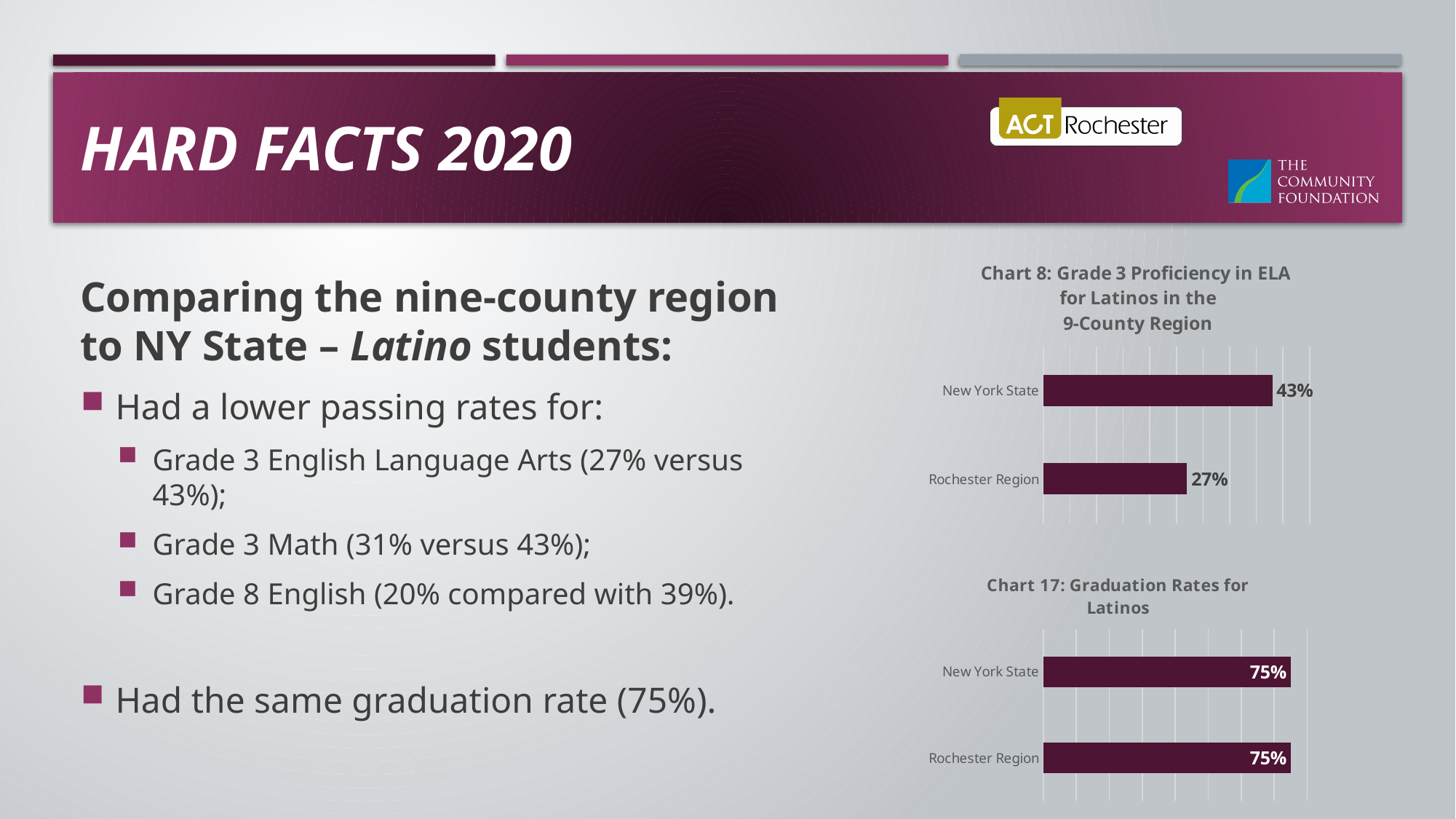
In Chart 8: Grade 3 Proficiency in ELA for Latinos in the 9-County Region, which is larger, the value for New York State or for Rochester Region? New York State What kind of chart is Chart 8: Grade 3 Proficiency in ELA for Latinos in the 9-County Region? Bar chart In Chart 8: Grade 3 Proficiency in ELA for Latinos in the 9-County Region, what is the value for New York State? 43% In Chart 8: Grade 3 Proficiency in ELA for Latinos in the 9-County Region, what is the difference between the New York State and Rochester Region values? 16% How many categories are shown in Chart 8: Grade 3 Proficiency in ELA for Latinos in the 9-County Region? 2 In Chart 17: Graduation Rates for Latinos, what is the value for Rochester Region? 75% What is the title of the lower chart on the slide? Chart 17: Graduation Rates for Latinos In Chart 8: Grade 3 Proficiency in ELA for Latinos in the 9-County Region, what is the value for Rochester Region? 27% In Chart 17: Graduation Rates for Latinos, what is the difference between the New York State and Rochester Region values? 0% In Chart 8: Grade 3 Proficiency in ELA for Latinos in the 9-County Region, which category has the lowest value? Rochester Region In Chart 17: Graduation Rates for Latinos, what is the value for New York State? 75% In Chart 8: Grade 3 Proficiency in ELA for Latinos in the 9-County Region, which category has the highest value? New York State